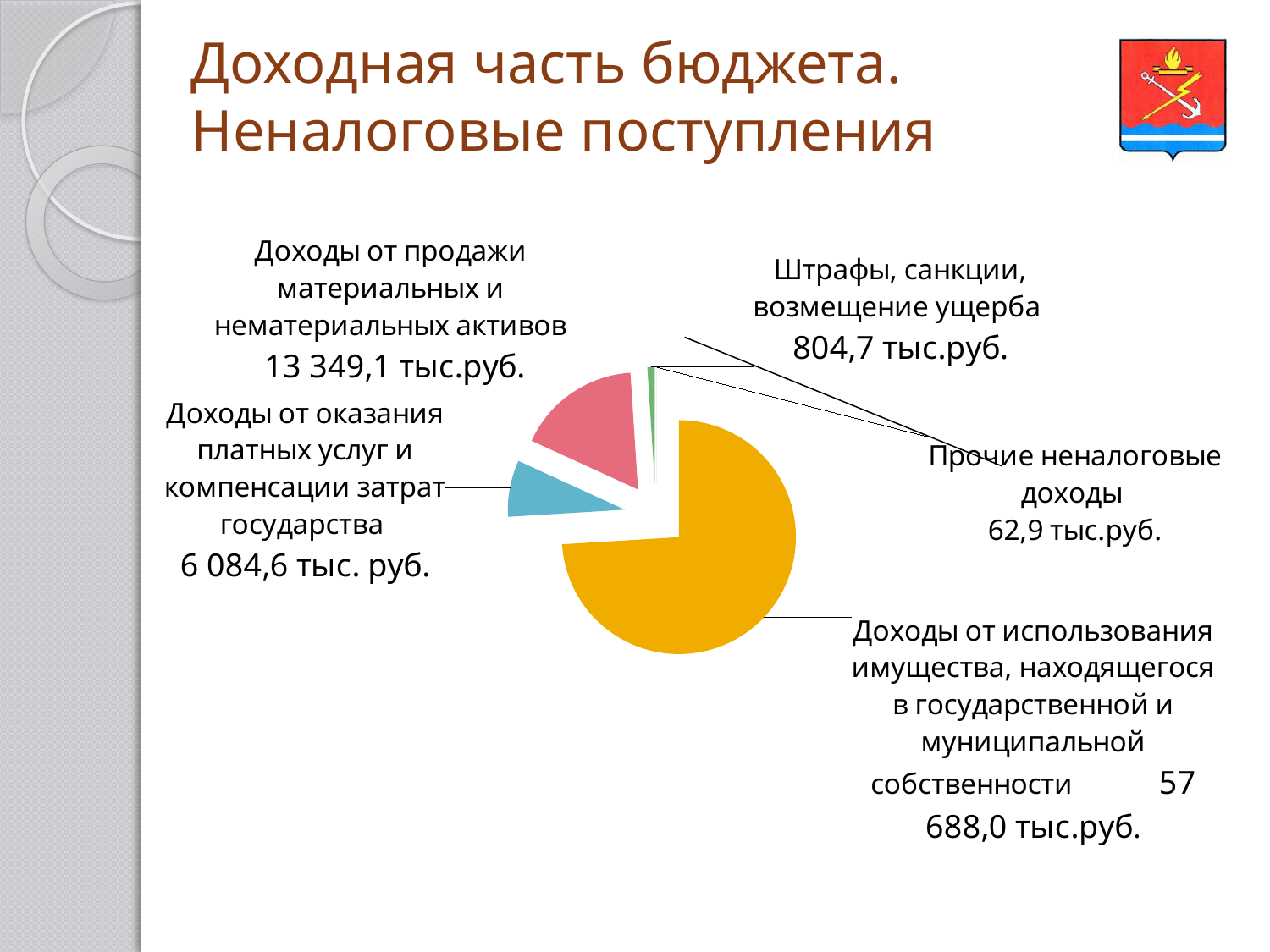
What is the value for «Прочие неналоговые доходы»? 62,9 тыс.руб. Which is larger: «Доходы от продажи материальных и нематериальных активов» or «Доходы от оказания платных услуг и компенсации затрат государства»? Доходы от продажи материальных и нематериальных активов What is the value for «Доходы от продажи материальных и нематериальных активов»? 13 349,1 тыс.руб. Which category has the smallest slice of the pie? Прочие неналоговые доходы What is the value for «Доходы от оказания платных услуг и компенсации затрат государства»? 6 084,6 тыс. руб. What is the value for «Штрафы, санкции, возмещение ущерба»? 804,7 тыс.руб. What kind of chart is shown on the slide? Pie chart What is the difference between «Доходы от продажи материальных и нематериальных активов» and «Доходы от оказания платных услуг и компенсации затрат государства»? 7 264,5 тыс.руб. Which category has the largest slice of the pie? Доходы от использования имущества, находящегося в государственной и муниципальной собственности How many slices does the pie chart have? 5 What is the difference between «Штрафы, санкции, возмещение ущерба» and «Прочие неналоговые доходы»? 741,8 тыс.руб. What is the value for «Доходы от использования имущества, находящегося в государственной и муниципальной собственности»? 57 688,0 тыс.руб.